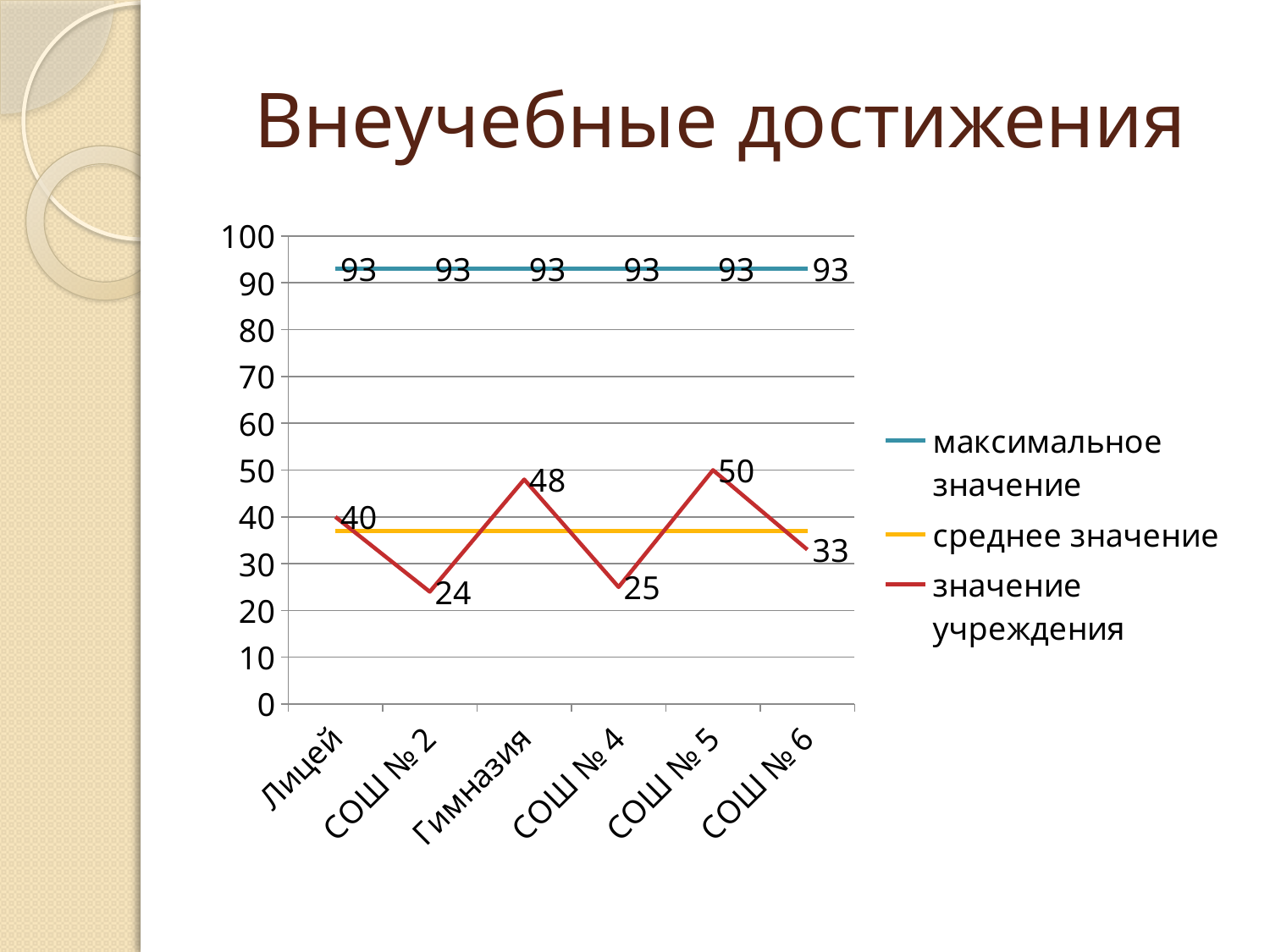
What is the value of "максимальное значение" for СОШ № 4? 93 What is the value of "значение учреждения" for СОШ № 2? 24 Is the "среднее значение" for Гимназия greater or less than 40? less Which is larger, the "значение учреждения" for Лицей or for СОШ № 4? Лицей What is the difference between the "значение учреждения" for СОШ № 5 and СОШ № 6? 17 What is the value of "значение учреждения" for Гимназия? 48 What is the value of "значение учреждения" for Лицей? 40 How many series does the legend list? 3 Which institution has the lowest "значение учреждения"? СОШ № 2 How many institutions are shown on the x axis? 6 Which institution has the highest "значение учреждения"? СОШ № 5 What type of chart is shown on the slide? line chart